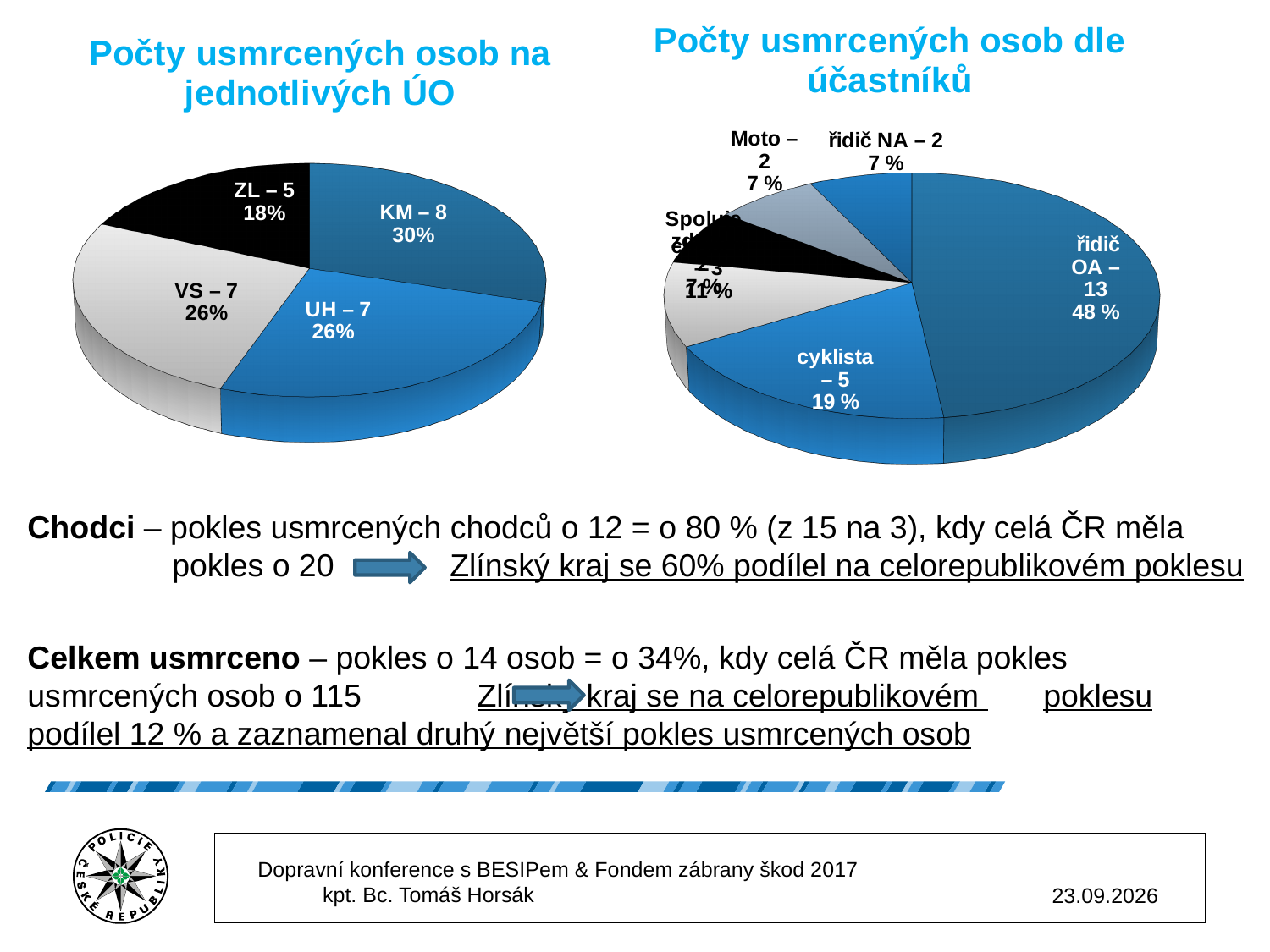
In the left chart (Počty usmrcených osob na jednotlivých ÚO), what is the difference between the values for KM and ZL? 3 In the right chart (Počty usmrcených osob dle účastníků), what is the difference between the values for řidič OA and cyklista? 8 In the left chart (Počty usmrcených osob na jednotlivých ÚO), what is the value for KM? 8 In the left chart (Počty usmrcených osob na jednotlivých ÚO), which category has the lowest value? ZL In the right chart (Počty usmrcených osob dle účastníků), which is larger, the value for cyklista or the value for Moto? cyklista In the left chart (Počty usmrcených osob na jednotlivých ÚO), how many slices does the pie have? 4 In the right chart (Počty usmrcených osob dle účastníků), what share of the pie does cyklista have? 19 % In the right chart (Počty usmrcených osob dle účastníků), what is the value for řidič OA? 13 In the left chart (Počty usmrcených osob na jednotlivých ÚO), what share of the pie does ZL have? 18% What kind of chart is the left chart (Počty usmrcených osob na jednotlivých ÚO)? Pie chart In the left chart (Počty usmrcených osob na jednotlivých ÚO), which category has the highest value? KM In the right chart (Počty usmrcených osob dle účastníků), which category has the highest value? řidič OA